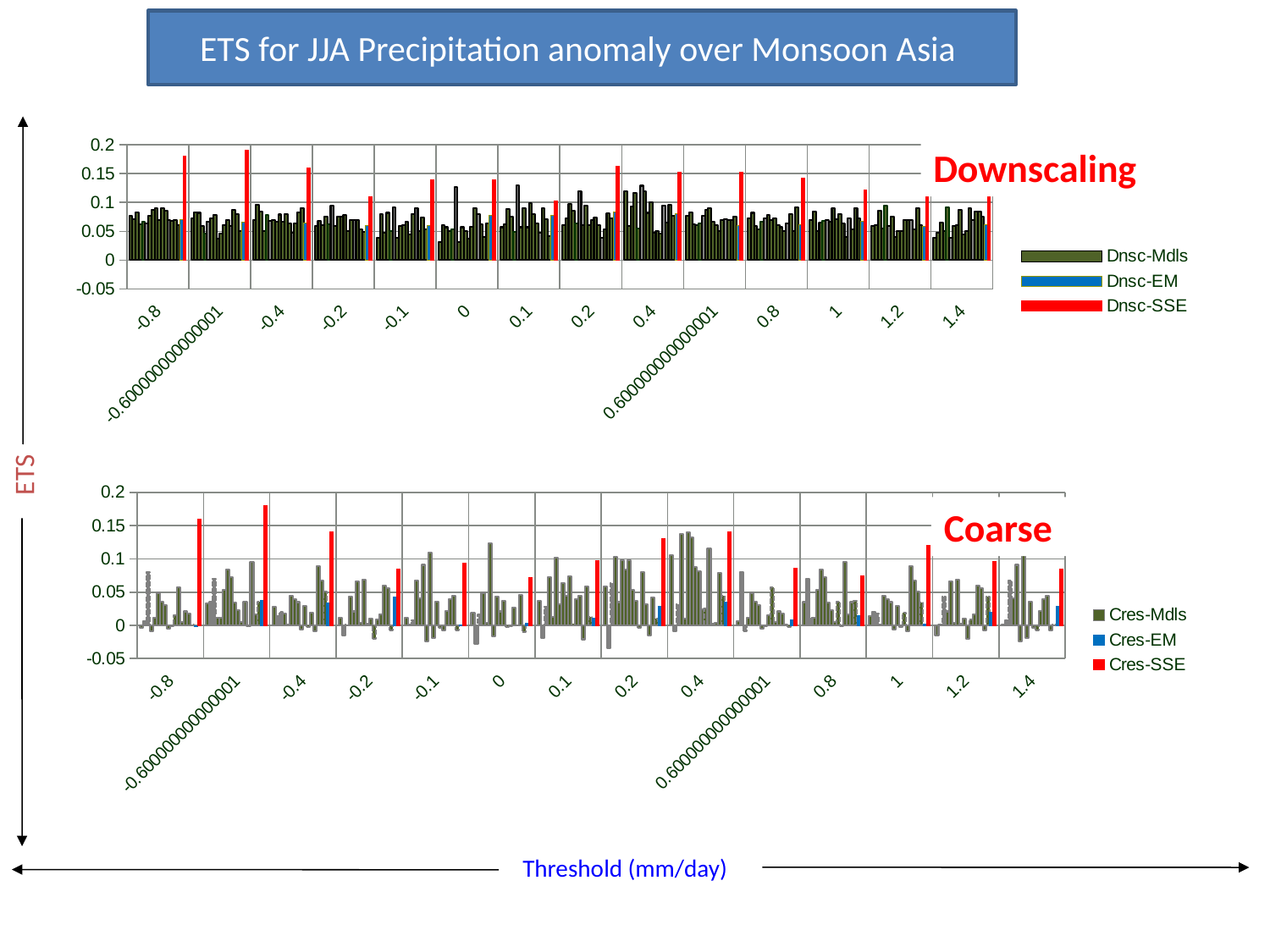
Which series is shown in red in the Downscaling chart's legend? Dnsc-SSE In the Coarse chart, is the Cres-SSE value larger at threshold -0.4 or at threshold -0.2? -0.4 In the Downscaling chart, is the Dnsc-SSE value at threshold -0.6000000000000001 greater or less than 0.15? greater How many series does the legend of the Coarse chart list? 3 In the Coarse chart, is the Cres-SSE value at threshold -0.6000000000000001 greater or less than 0.15? greater In the Downscaling chart, is the Dnsc-SSE value larger at threshold 0.1 or at threshold 0.2? 0.2 What kind of chart is the Downscaling chart? bar chart In the Downscaling chart, is the Dnsc-SSE value at threshold 0 greater or less than 0.1? greater What is the label of the shared x axis below the two charts? Threshold (mm/day) How many threshold categories are shown on the x axis of the Downscaling chart? 14